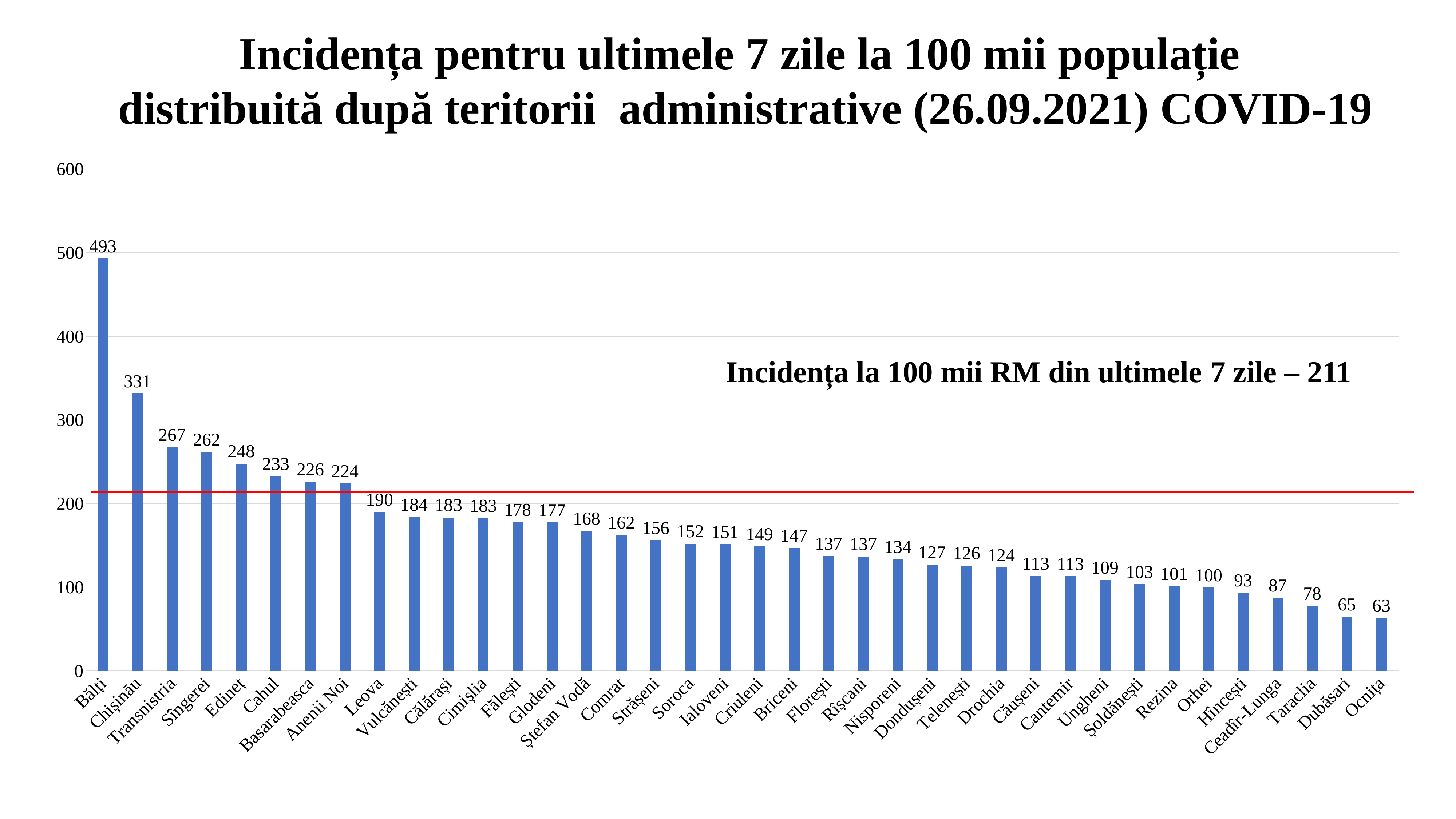
Which has a higher incidence, Cahul or Leova? Cahul How many territories are shown on the chart? 38 What kind of chart is shown on the slide? bar chart What is the incidence value for Bălți? 493 Do the values rise or fall from left to right along the x axis? fall Which territory has the lowest incidence? Ocnița What national incidence value for RM is stated in the text on the chart? 211 What is the difference between the incidence for Bălți and Chișinău? 162 What is the incidence value for Orhei? 100 Which territory has the highest incidence? Bălți Is the value for Edineț greater or less than 200? greater What is the incidence value for Chișinău? 331